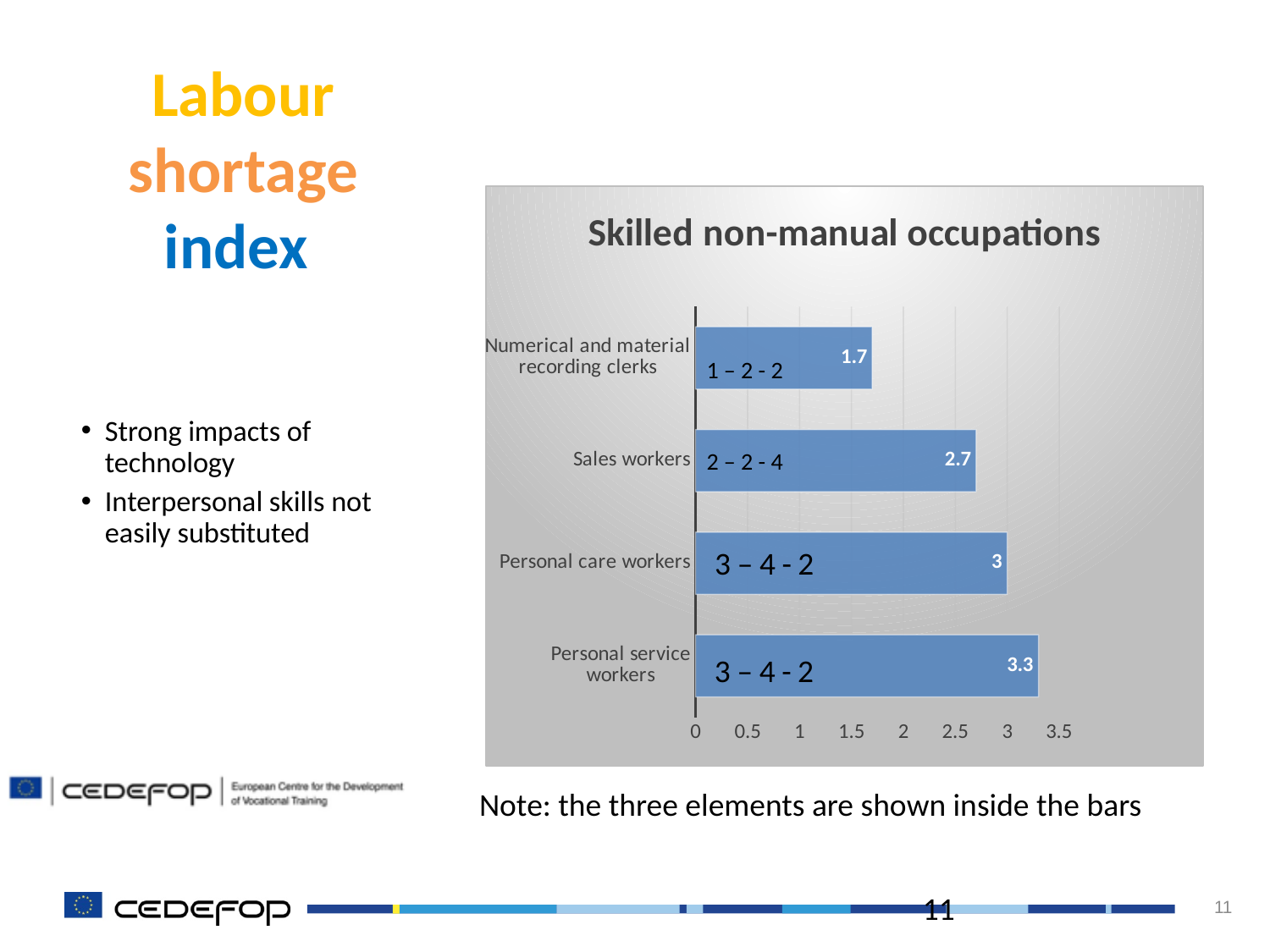
What type of chart is shown on the slide? Bar chart What is the title of the chart? Skilled non-manual occupations How many occupations are shown in the chart? 4 What is the value for Numerical and material recording clerks? 1.7 Which occupation has the highest value? Personal service workers What is the value for Sales workers? 2.7 What is the value for Personal care workers? 3 What is the difference between the values for Personal service workers and Numerical and material recording clerks? 1.6 Which has a larger value, Sales workers or Personal care workers? Personal care workers What is the value for Personal service workers? 3.3 Which occupation has the lowest value? Numerical and material recording clerks What is the difference between the values for Sales workers and Personal care workers? 0.3